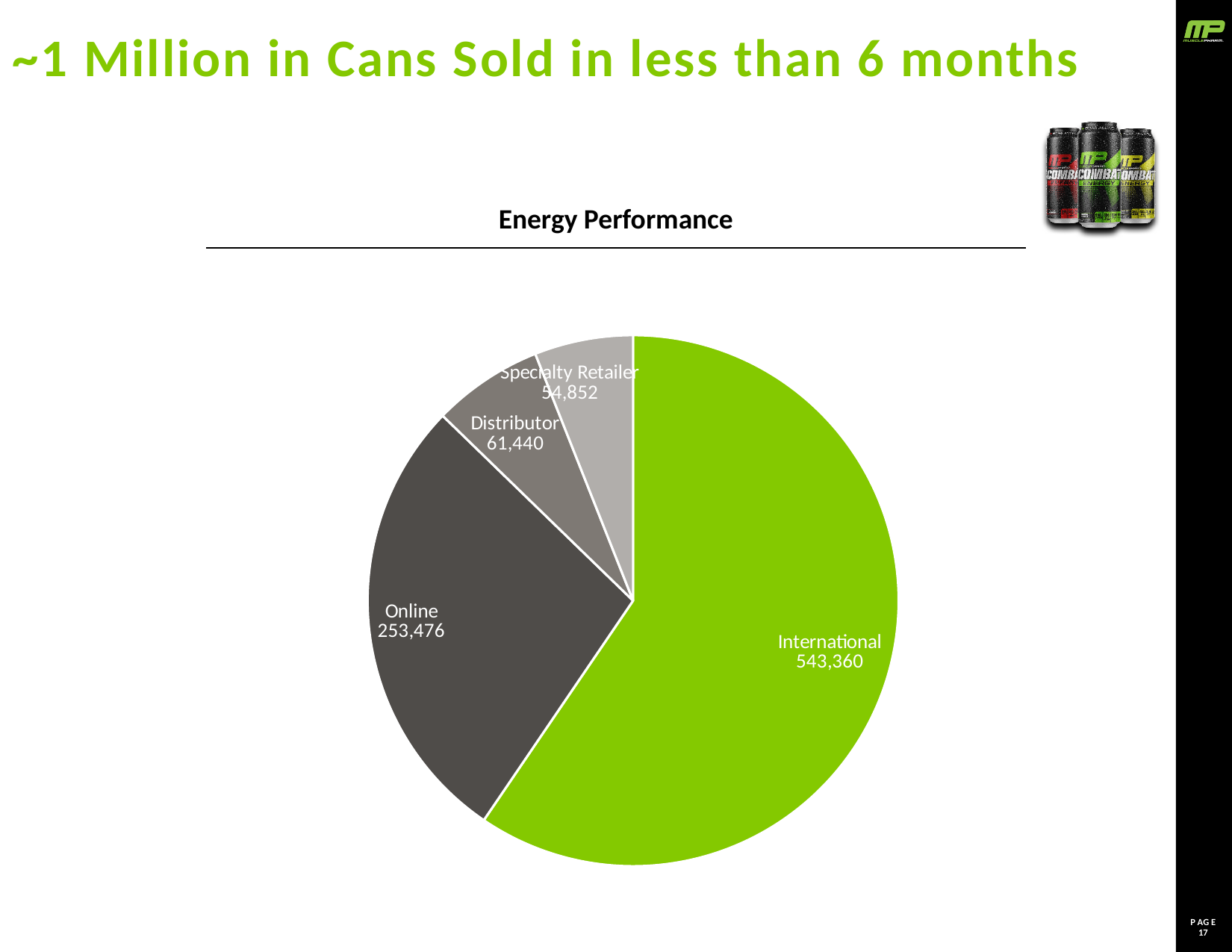
What value is shown for Distributor in the Energy Performance chart? 61,440 How many categories are shown in the Energy Performance pie chart? 4 Which category has the smallest slice in the Energy Performance pie chart? Specialty Retailer Which is larger in the Energy Performance chart, Online or Distributor? Online What value is shown for Specialty Retailer in the Energy Performance chart? 54,852 What is the difference between the International and Online values in the Energy Performance chart? 289,884 What is the value shown for Online in the Energy Performance chart? 253,476 Which category has the largest slice in the Energy Performance pie chart? International What is the title of the chart on the slide? Energy Performance What is the value of the International slice in the Energy Performance pie chart? 543,360 What type of chart is used to show Energy Performance? Pie chart What is the difference between the Distributor and Specialty Retailer values in the Energy Performance chart? 6,588